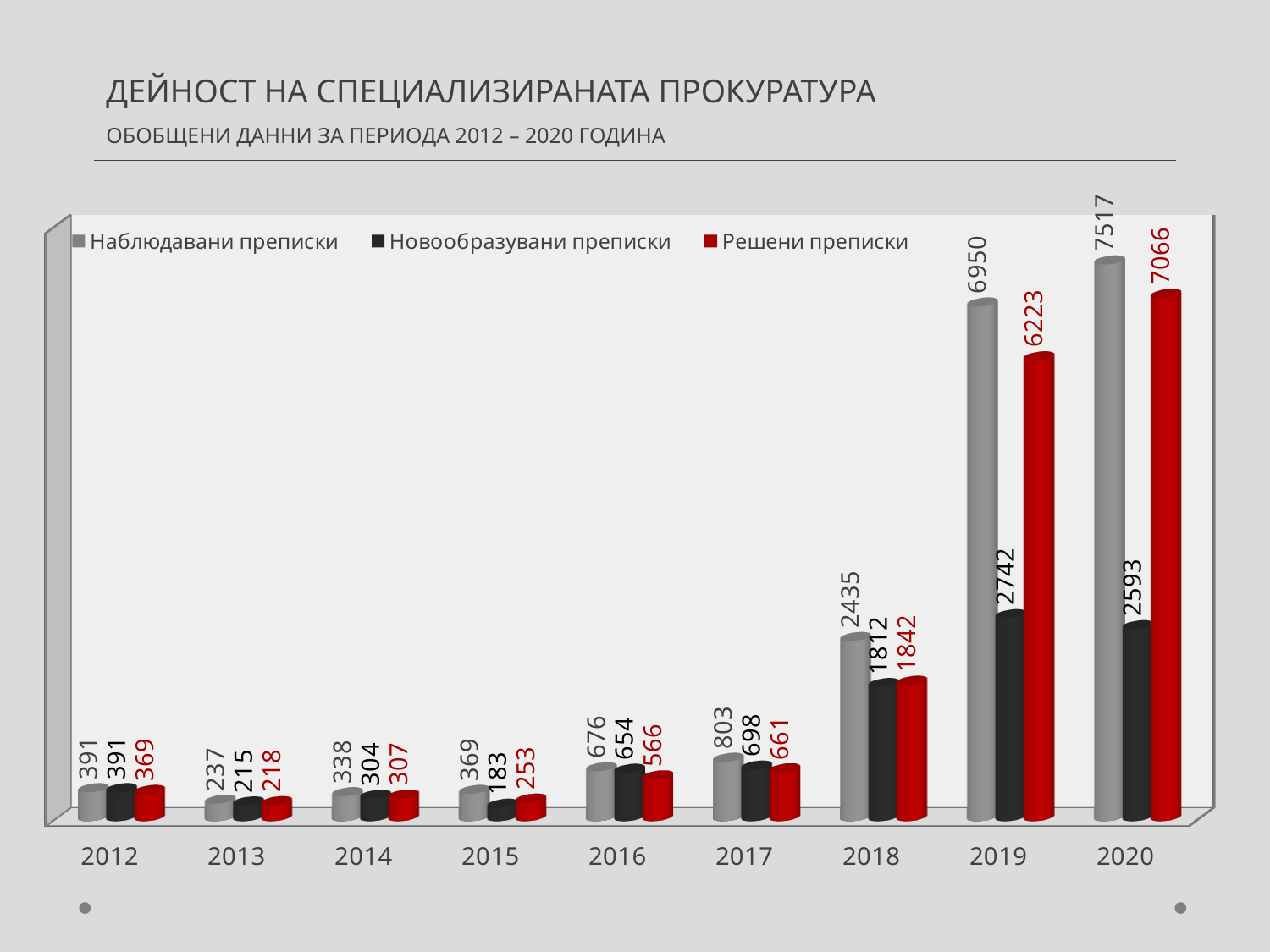
Which year has the lowest value for Решени преписки? 2013 How many years are shown on the x axis? 9 What colour are the bars for Решени преписки? red What is the value of Решени преписки for 2020? 7066 Which is larger in 2019: Новообразувани преписки or Решени преписки? Решени преписки What is the value of Наблюдавани преписки for 2019? 6950 Does the value of Решени преписки rise or fall from 2017 to 2020? rise What is the difference between Наблюдавани преписки and Решени преписки in 2020? 451 Which year has the highest value for Наблюдавани преписки? 2020 What kind of chart is shown on the slide? bar chart What is the value of Новообразувани преписки for 2015? 183 How many series does the legend list? 3